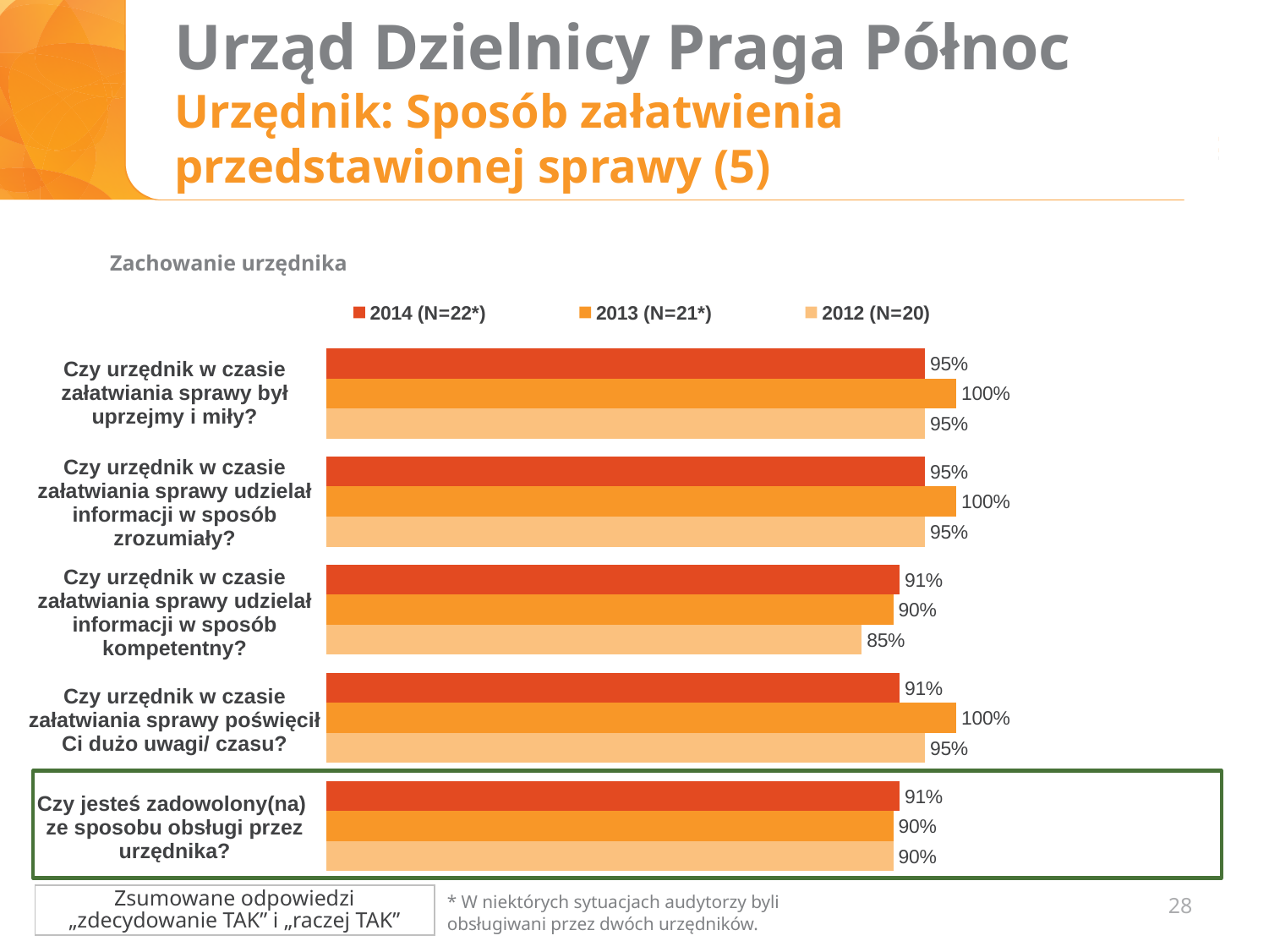
What is the difference between the 2014 and 2012 values for "Czy urzędnik w czasie załatwiania sprawy udzielał informacji w sposób kompetentny?"? 6% What is the title shown above the chart? Zachowanie urzędnika What is the 2013 (N=21*) value for "Czy urzędnik w czasie załatwiania sprawy poświęcił Ci dużo uwagi/ czasu?"? 100% What is the difference between the 2013 and 2014 values for "Czy urzędnik w czasie załatwiania sprawy poświęcił Ci dużo uwagi/ czasu?"? 9% Which year has the lowest value for "Czy urzędnik w czasie załatwiania sprawy udzielał informacji w sposób kompetentny?"? 2012 (N=20) How many series does the chart legend list? 3 What is the 2012 (N=20) value for "Czy urzędnik w czasie załatwiania sprawy udzielał informacji w sposób zrozumiały?"? 95% For "Czy urzędnik w czasie załatwiania sprawy był uprzejmy i miły?", which is larger: the 2013 value or the 2014 value? 2013 (N=21*) What is the 2012 (N=20) value for "Czy urzędnik w czasie załatwiania sprawy udzielał informacji w sposób kompetentny?"? 85% What is the 2014 (N=22*) value for "Czy jesteś zadowolony(na) ze sposobu obsługi przez urzędnika?"? 91% How many question categories are plotted in the chart? 5 What type of chart is shown on the slide? bar chart